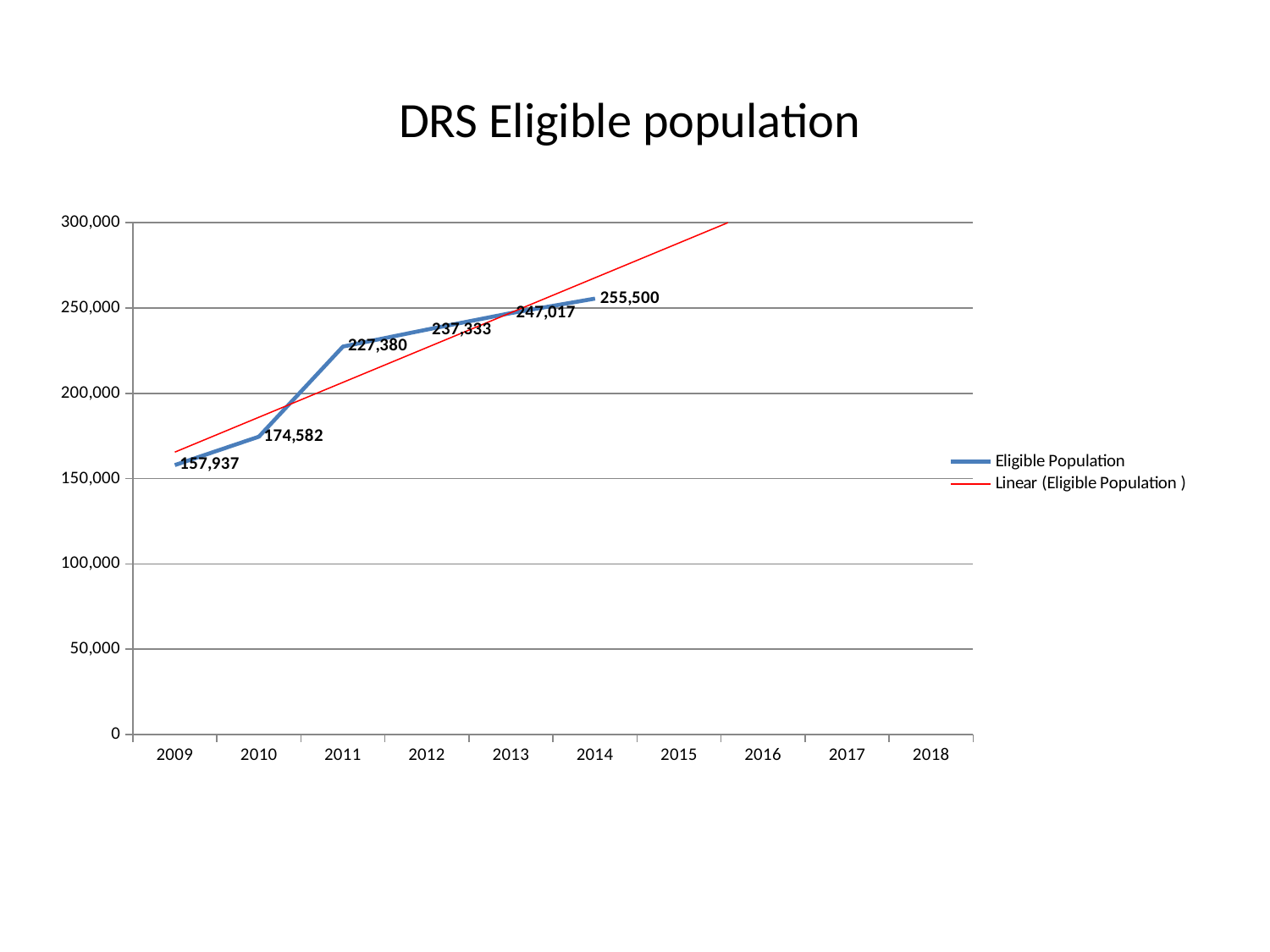
Which year has the lowest Eligible Population value? 2009 What is the Eligible Population value for 2014? 255,500 How many data points with labels are plotted for the Eligible Population series? 6 Which year has the highest Eligible Population value? 2014 What is the Eligible Population value for 2011? 227,380 Which is larger, the Eligible Population value for 2012 or for 2013? 2013 Does the Eligible Population rise or fall from 2009 to 2014? rise What is the difference between the Eligible Population values for 2011 and 2010? 52,798 Is the Eligible Population value for 2010 greater or less than 200,000? less How many entries does the legend list? 2 What is the Eligible Population value for 2009? 157,937 What is the difference between the Eligible Population values for 2014 and 2009? 97,563